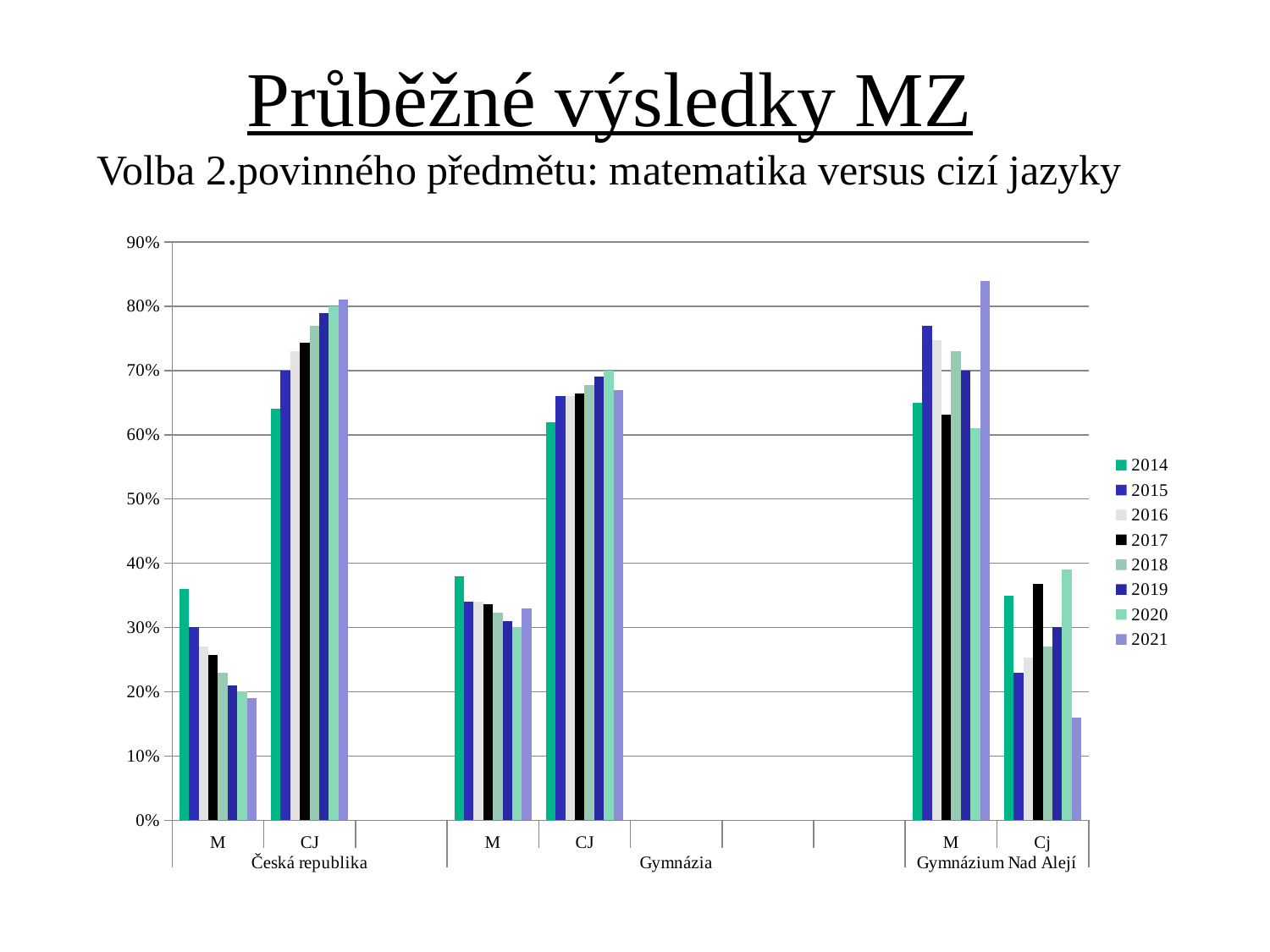
For M under Gymnázium Nad Alejí, which year has the highest value? 2021 Under Česká republika, which has the larger 2014 value, M or CJ? CJ How many series does the legend list? 8 For M under Česká republika, do the values rise or fall from 2014 to 2021? fall Is the 2021 value for M under Gymnázium Nad Alejí greater or less than 80%? greater How many labelled groups of bars (M/CJ categories) are shown along the x axis? 6 Is the 2014 value for M under Česká republika greater or less than 40%? less What kind of chart is shown on the slide? bar chart Is the 2014 value for M under Gymnázia greater or less than 30%? greater What colour are the bars for the 2017 series? black For Cj under Gymnázium Nad Alejí, which year has the lowest value? 2021